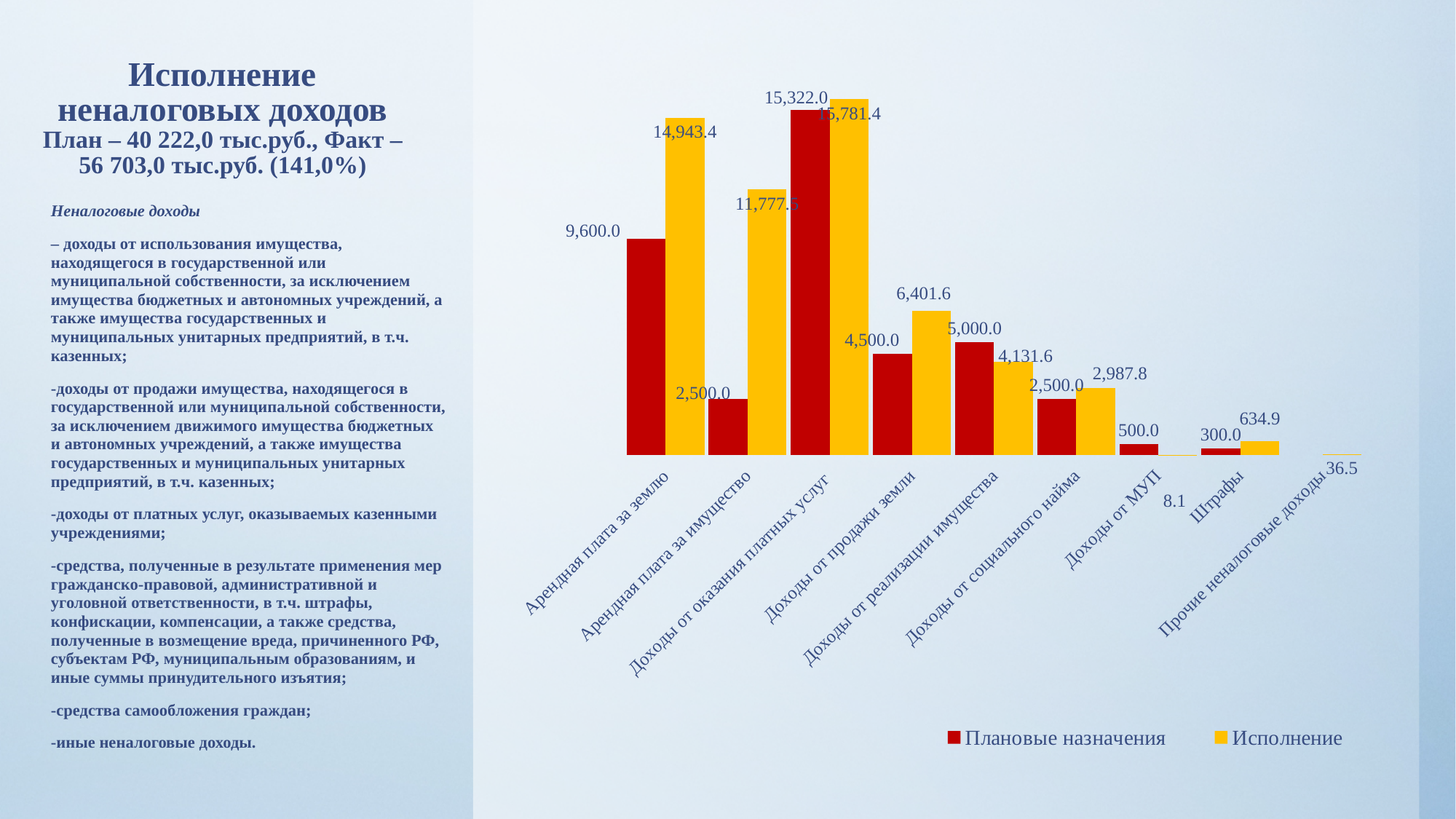
What kind of chart is shown on the slide? Bar chart What colour represents the Исполнение series in the chart? Yellow What is the difference between Исполнение and Плановые назначения for Штрафы? 334.9 How many series does the chart legend list? 2 Which category has the highest Исполнение value? Доходы от оказания платных услуг For Доходы от реализации имущества, which is larger: Плановые назначения or Исполнение? Плановые назначения How many categories are shown along the x axis of the chart? 9 What is the difference between Исполнение and Плановые назначения for Доходы от продажи земли? 1,901.6 What is the value of Плановые назначения for Арендная плата за землю? 9,600.0 What is the value of Исполнение for Доходы от продажи земли? 6,401.6 What is the value of Исполнение for Доходы от МУП? 8.1 What is the value of Исполнение for Арендная плата за землю? 14,943.4